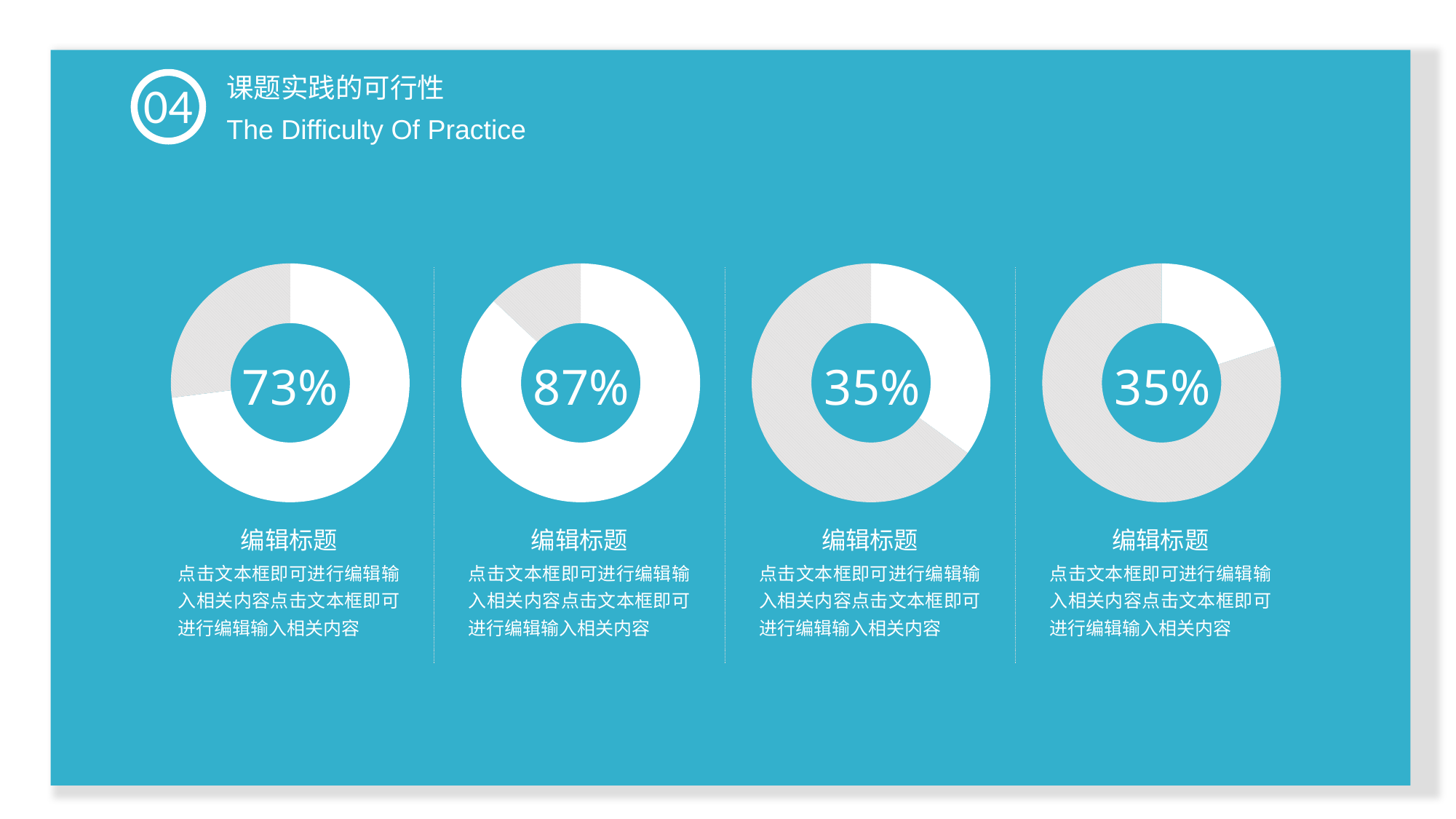
What is the lowest percentage shown across the four donut charts? 35% How many donut charts are on the slide? 4 What value is shown in the centre of the second donut chart from the left? 87% What is the difference between the value in the second donut chart and the value in the leftmost donut chart? 14% Which donut chart shows the highest percentage? The second from the left (87%) What is the difference between the value in the leftmost donut chart and the value in the rightmost donut chart? 38% What value is shown in the centre of the rightmost donut chart? 35% What kind of chart is used to display the percentages on this slide? Donut chart What is the English subtitle of the slide? The Difficulty Of Practice What value is shown in the centre of the third donut chart from the left? 35% Which is larger, the value in the leftmost donut chart or the value in the second donut chart? The second donut chart (87%) What value is shown in the centre of the leftmost donut chart? 73%